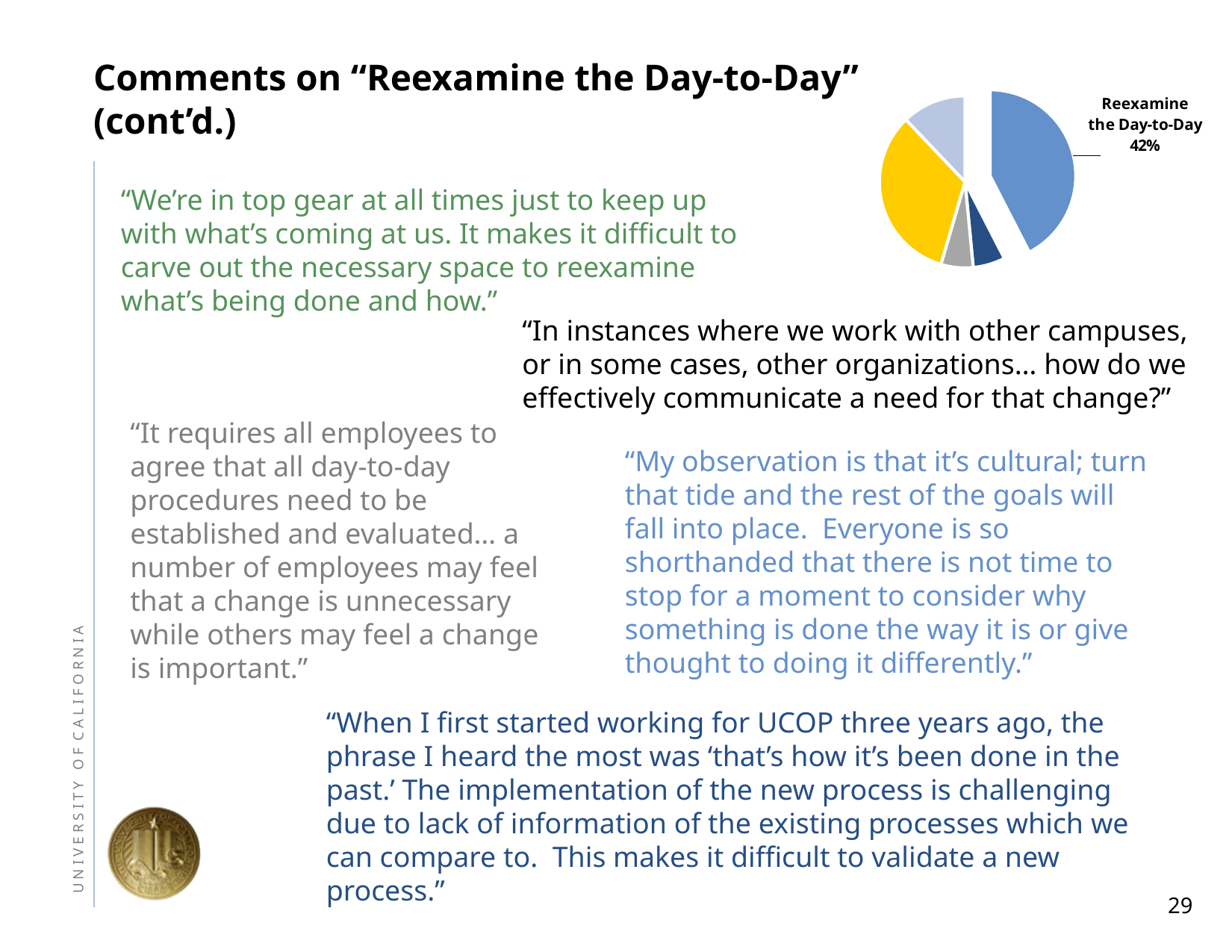
What share of the pie chart is labeled "Reexamine the Day-to-Day"? 42% What colour is the "Reexamine the Day-to-Day" slice of the pie chart? blue Which slice of the pie chart is labeled with a percentage? Reexamine the Day-to-Day Which slice of the pie chart is the largest? Reexamine the Day-to-Day What kind of chart is shown in the top right of the slide? pie chart How many slices does the pie chart have? 5 Which slice of the pie chart is pulled out (exploded) from the rest? Reexamine the Day-to-Day